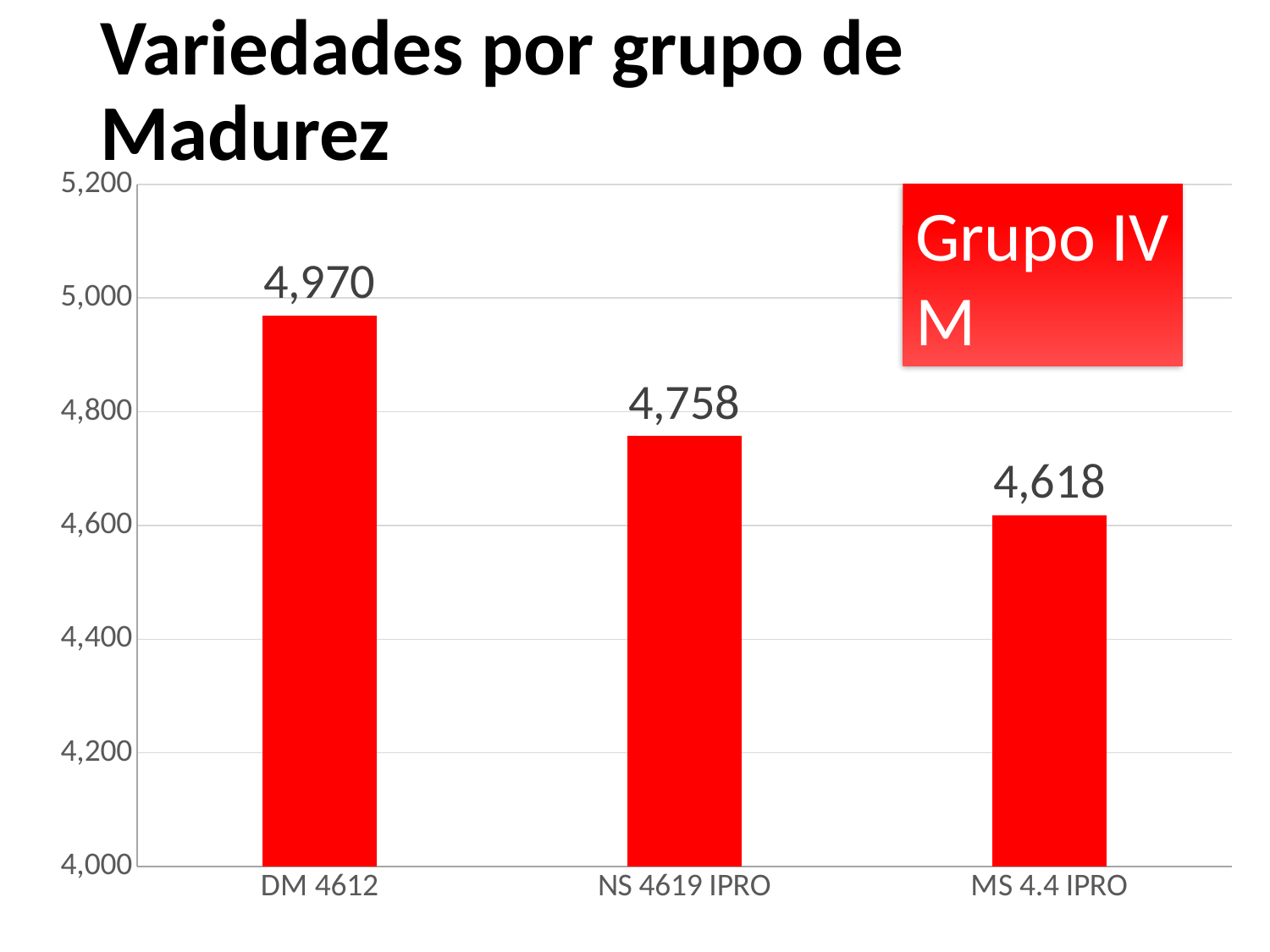
Is the value for NS 4619 IPRO greater or less than 4,800? less Which variety has the lowest value? MS 4.4 IPRO What is the value for DM 4612? 4,970 Which is larger, the value for DM 4612 or the value for MS 4.4 IPRO? DM 4612 What is the value for NS 4619 IPRO? 4,758 How many varieties are shown in the chart? 3 What kind of chart is shown on the slide? bar chart Do the values rise or fall from left to right across the varieties? fall Which variety has the highest value? DM 4612 What is the difference between the values for DM 4612 and NS 4619 IPRO? 212 What is the value for MS 4.4 IPRO? 4,618 What is the difference between the values for NS 4619 IPRO and MS 4.4 IPRO? 140